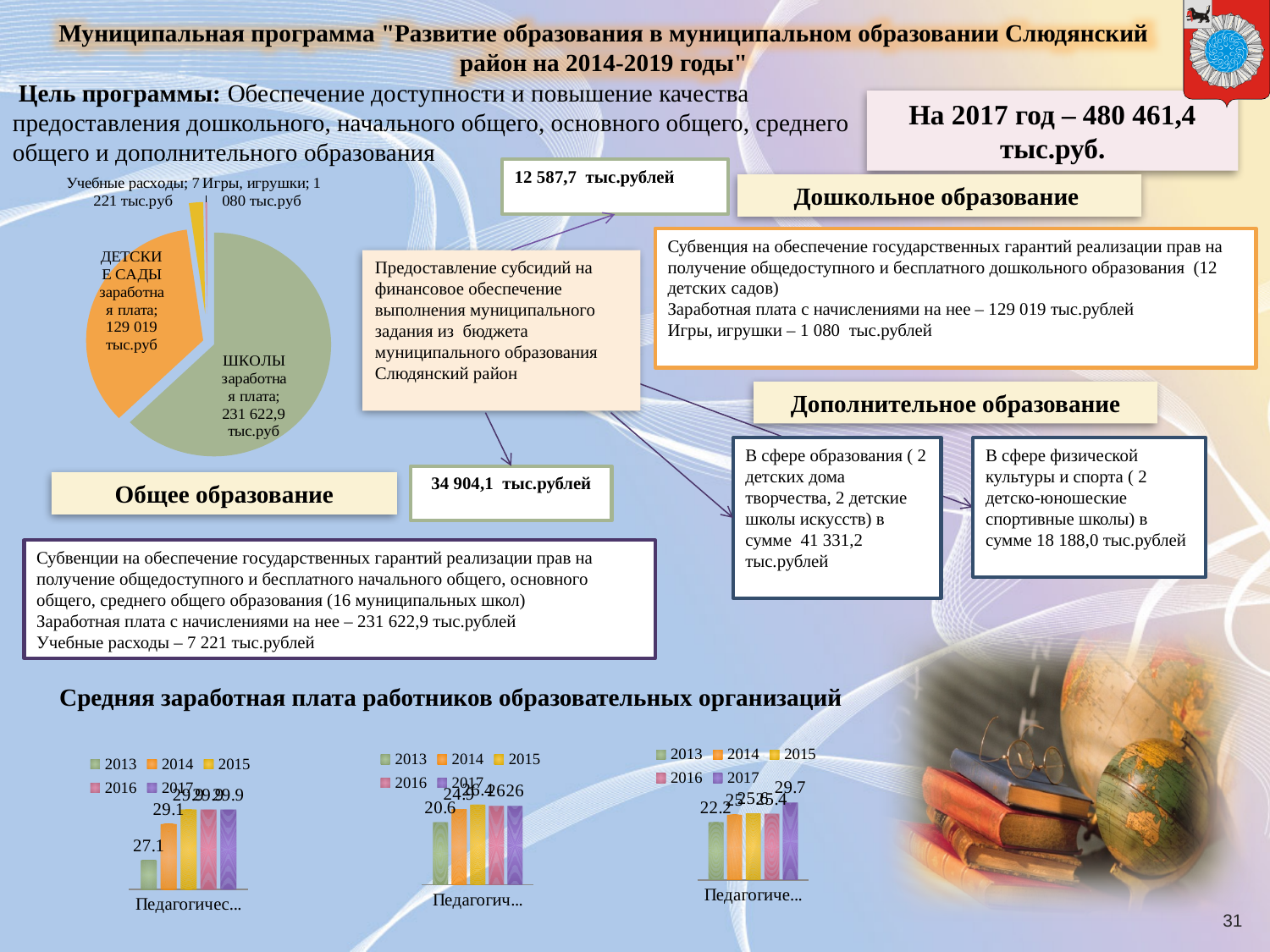
In the rightmost bar chart at the bottom of the slide, which is larger, the value for 2013 or the value for 2017? 2017 In the leftmost bar chart at the bottom of the slide, what is the value for 2013? 27.1 In the pie chart at the top left, what is the value for Игры, игрушки? 1 080 тыс.руб What kind of chart is the chart at the top left of the slide? pie chart In the pie chart at the top left, what is the value for Учебные расходы? 7 221 тыс.руб In the pie chart at the top left, which slice is the largest? ШКОЛЫ заработная плата In the pie chart at the top left, which slice is the smallest? Игры, игрушки In the pie chart at the top left, what is the difference between the ШКОЛЫ заработная плата value and the ДЕТСКИЕ САДЫ заработная плата value? 102 603,9 тыс.руб In the pie chart at the top left, what is the value for ШКОЛЫ заработная плата? 231 622,9 тыс.руб In the pie chart at the top left, how many slices are there? 4 How many series does the legend list in the leftmost bar chart at the bottom of the slide? 5 In the pie chart at the top left, what is the value for ДЕТСКИЕ САДЫ заработная плата? 129 019 тыс.руб